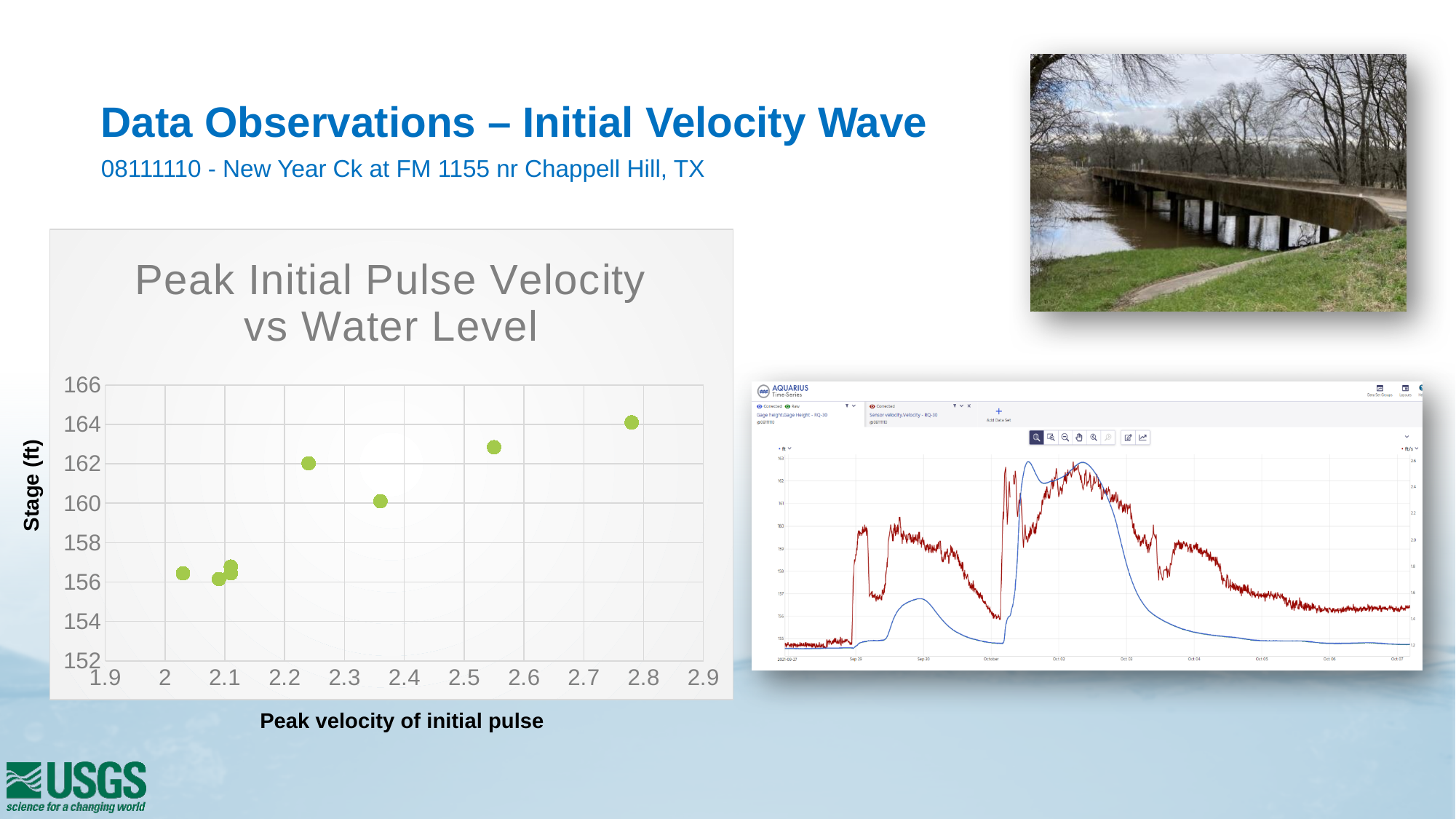
In the 'Peak Initial Pulse Velocity vs Water Level' chart, is the stage for the point near a peak velocity of 2.36 greater or less than 162? less What kind of chart is the 'Peak Initial Pulse Velocity vs Water Level' chart? scatter chart What is the y-axis label of the 'Peak Initial Pulse Velocity vs Water Level' chart? Stage (ft) What is the title of the chart on the left of the slide? Peak Initial Pulse Velocity vs Water Level In the 'Peak Initial Pulse Velocity vs Water Level' chart, is the stage for the point near a peak velocity of 2.24 greater or less than 160? greater In the 'Peak Initial Pulse Velocity vs Water Level' chart, do stage values generally rise or fall as peak velocity increases? rise What is the highest value shown on the y-axis of the 'Peak Initial Pulse Velocity vs Water Level' chart? 166 In the 'Peak Initial Pulse Velocity vs Water Level' chart, which point has the highest stage: the one near peak velocity 2.55 or the one near 2.78? the one near 2.78 In the 'Peak Initial Pulse Velocity vs Water Level' chart, is the stage for the point with the lowest peak velocity greater or less than 158? less In the 'Peak Initial Pulse Velocity vs Water Level' chart, which has the higher stage: the point near peak velocity 2.24 or the point near 2.36? the point near 2.24